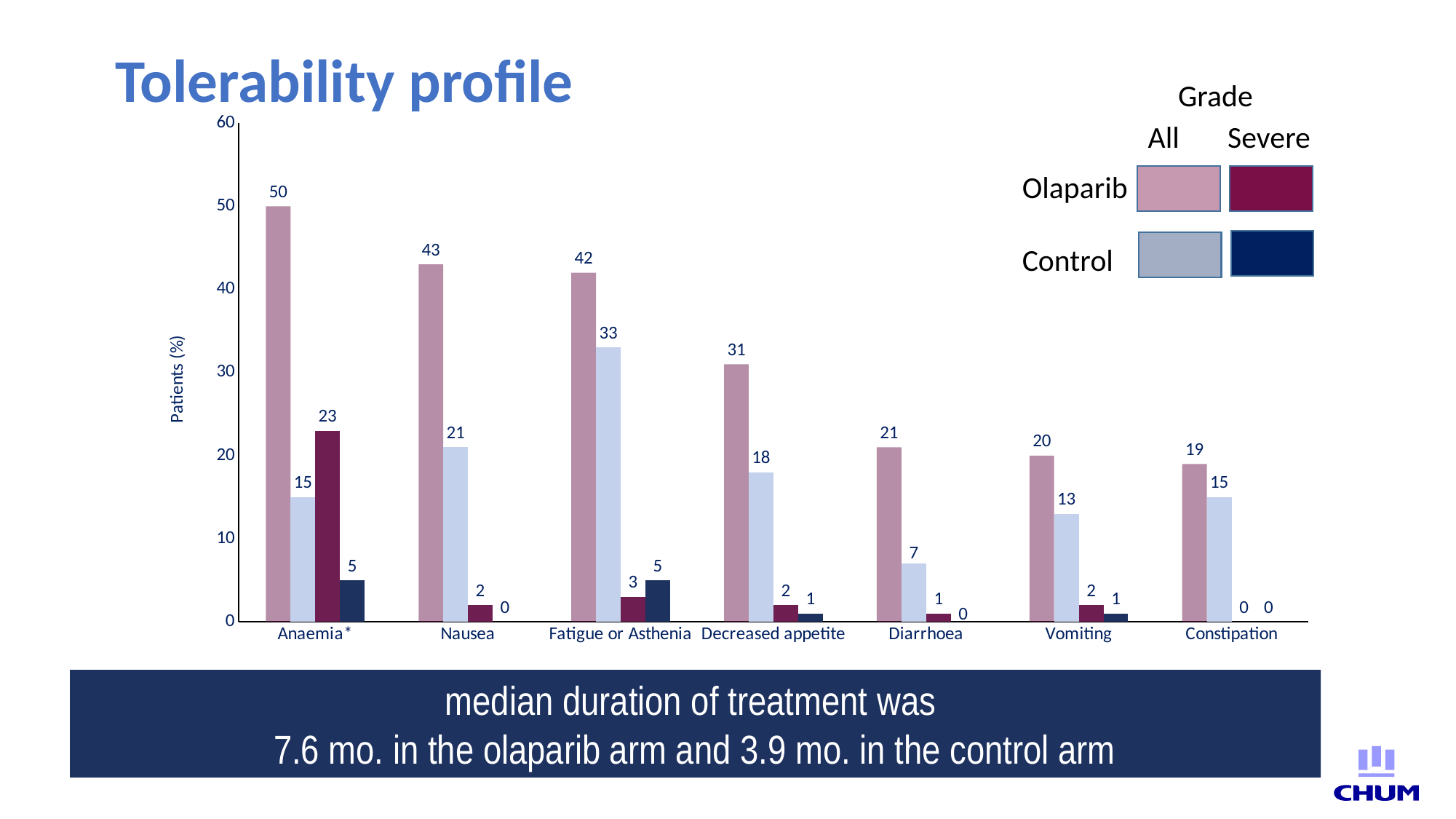
Which is larger for Vomiting: the Olaparib all-grade value or the Control all-grade value? Olaparib all-grade What is the label of the y axis? Patients (%) What is the Control all-grade value for Fatigue or Asthenia? 33 What is the Olaparib severe-grade value for Anaemia? 23 What kind of chart is shown on the slide? Bar chart How many series does the legend list? 4 What is the Olaparib all-grade value for Anaemia? 50 What is the Control severe-grade value for Decreased appetite? 1 What is the difference between the Olaparib all-grade and Control all-grade values for Nausea? 22 Which adverse event has the highest Olaparib all-grade value? Anaemia Which adverse event has the lowest Olaparib all-grade value? Constipation How many adverse event categories are shown on the x axis? 7